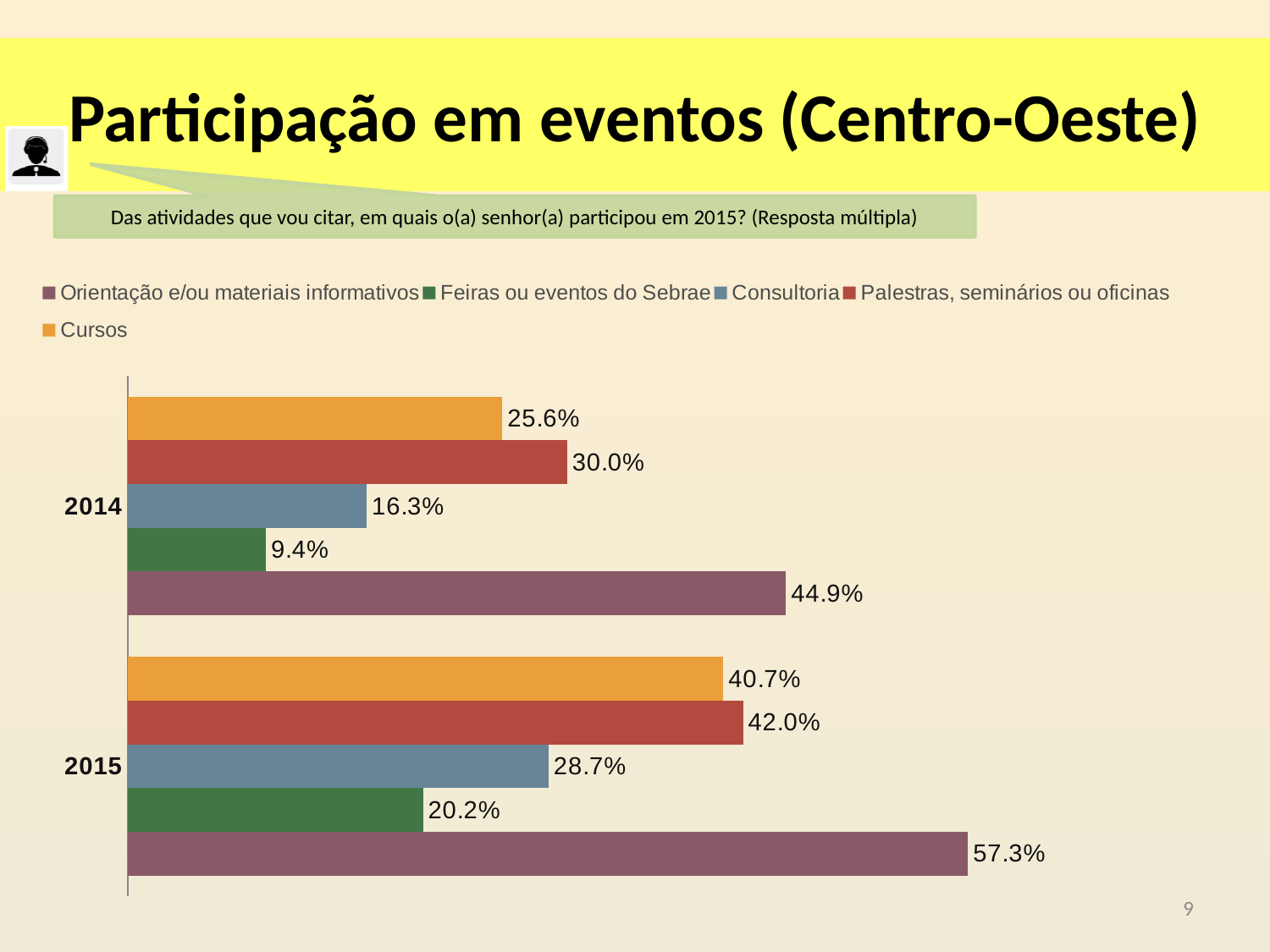
How many year categories are shown on the chart? 2 Which is larger: Palestras, seminários ou oficinas in 2015 or Cursos in 2015? Palestras, seminários ou oficinas in 2015 Which series has the lowest value in 2014? Feiras ou eventos do Sebrae What is the value for Consultoria in 2014? 16.3% What is the difference between the Orientação e/ou materiais informativos values for 2015 and 2014? 12.4% What is the value for Cursos in 2015? 40.7% How many series does the legend list? 5 Did the value for Consultoria rise or fall from 2014 to 2015? Rise What is the value for Orientação e/ou materiais informativos in 2015? 57.3% What kind of chart is shown on the slide? Bar chart Which series has the highest value in 2015? Orientação e/ou materiais informativos What is the value for Feiras ou eventos do Sebrae in 2014? 9.4%